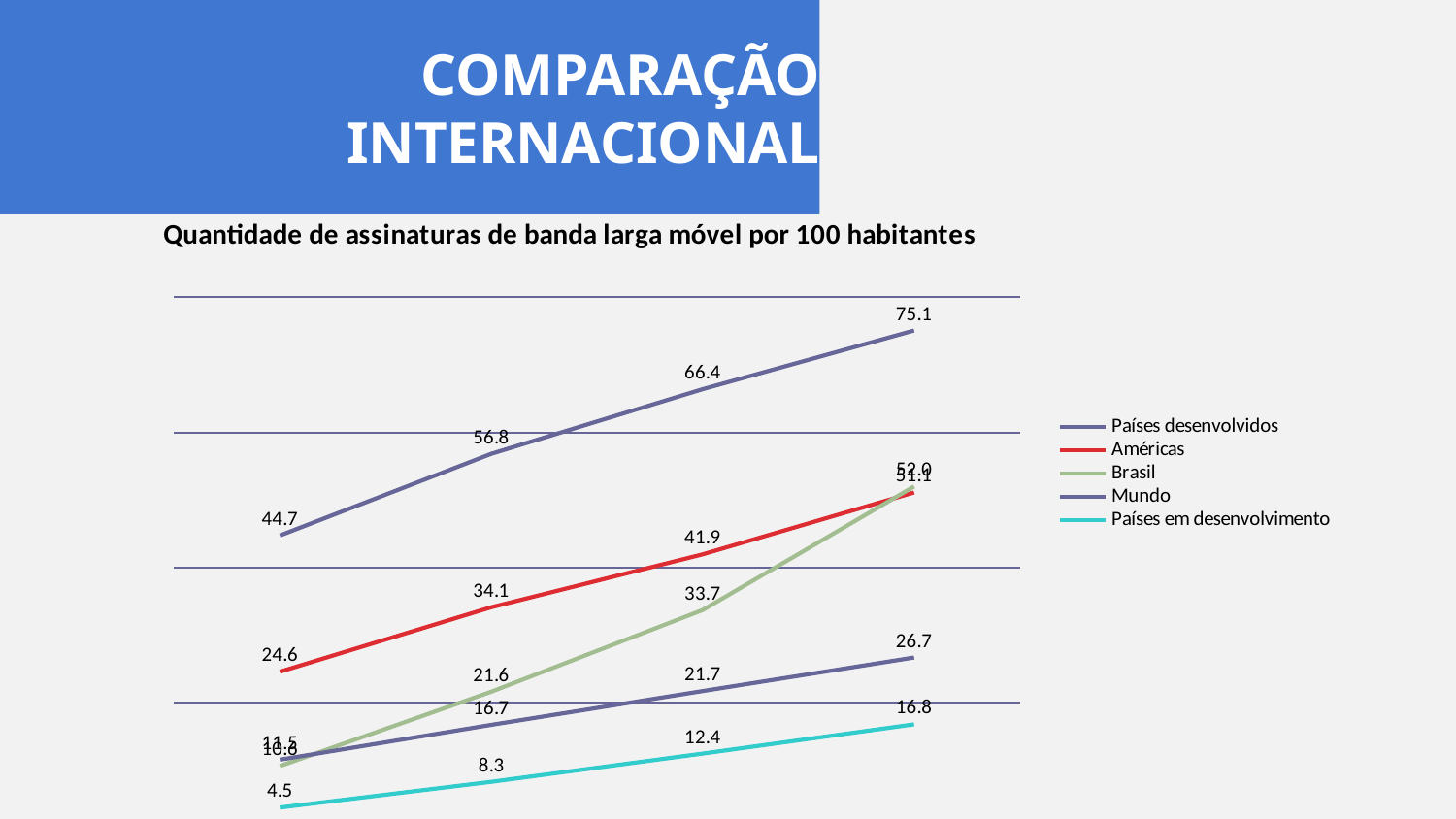
What is the last (rightmost) value for Mundo? 26.7 What type of chart is shown on the slide? line chart What is the first (leftmost) value for Países desenvolvidos? 44.7 What is the title of the chart? Quantidade de assinaturas de banda larga móvel por 100 habitantes What is the third value for Brasil? 33.7 What is the first (leftmost) value for Países em desenvolvimento? 4.5 How many series does the legend list? 5 What is the last (rightmost) value for Países desenvolvidos? 75.1 Do the values for Países em desenvolvimento rise or fall from left to right? rise Which series has the lowest value at the first point? Países em desenvolvimento What is the difference between the last and first values for Países desenvolvidos? 30.4 Which series has the highest value at the last point? Países desenvolvidos